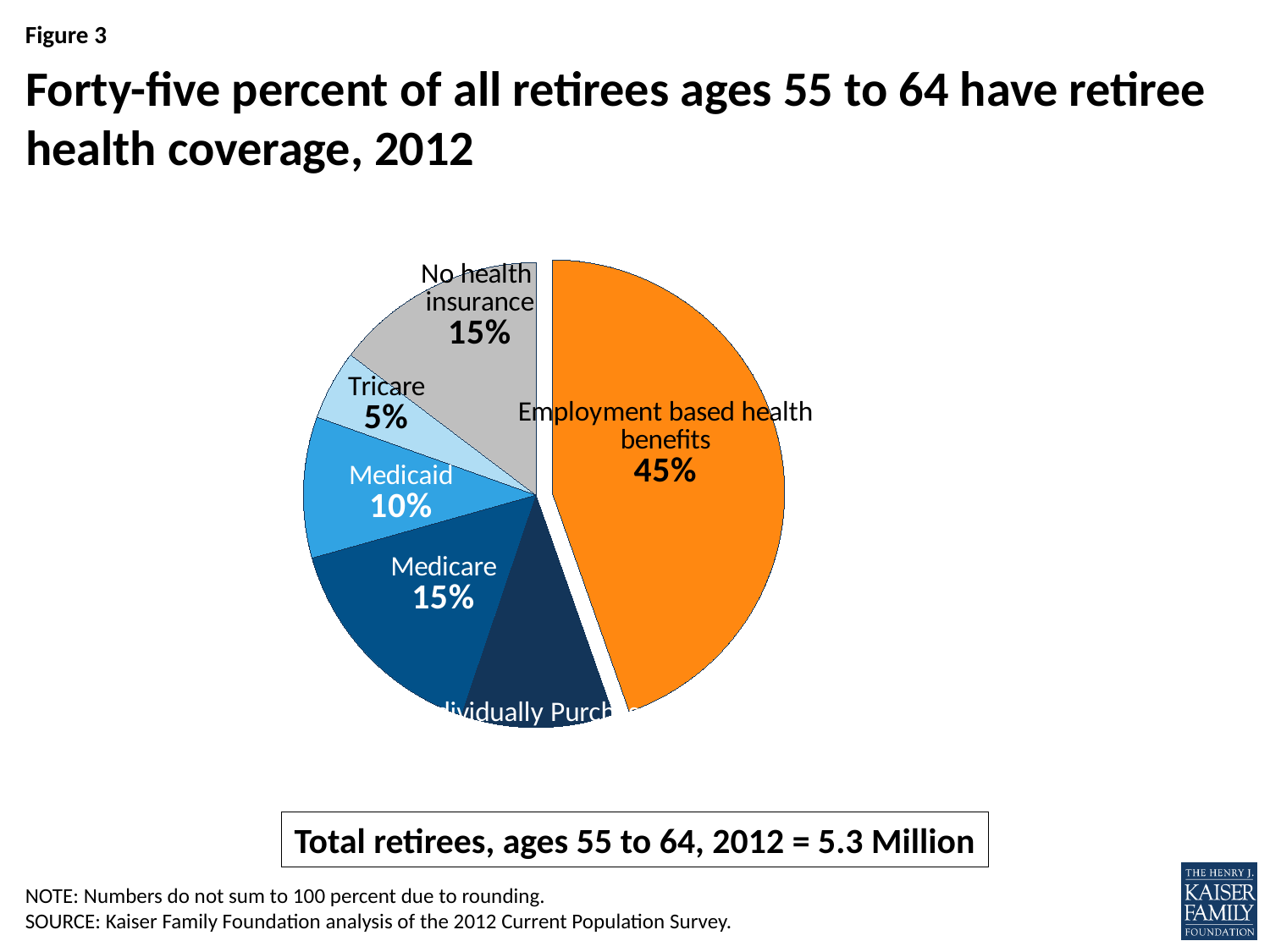
What share of retirees ages 55 to 64 have employment based health benefits? 45% What is the value shown for the Medicare slice? 15% What percentage of retirees ages 55 to 64 have no health insurance? 15% What is the value shown for the Tricare slice? 5% How many slices does the pie chart have? 6 What type of chart is shown on the slide? Pie chart Which labeled coverage category has the smallest share of the pie? Tricare Which is larger, the Medicaid share or the Tricare share? Medicaid According to the slide, what is the total number of retirees ages 55 to 64 in 2012? 5.3 Million Which coverage category has the largest share of the pie? Employment based health benefits How many percentage points larger is the employment based health benefits share than the Medicare share? 30 percentage points What percentage of retirees ages 55 to 64 are covered by Medicaid? 10%